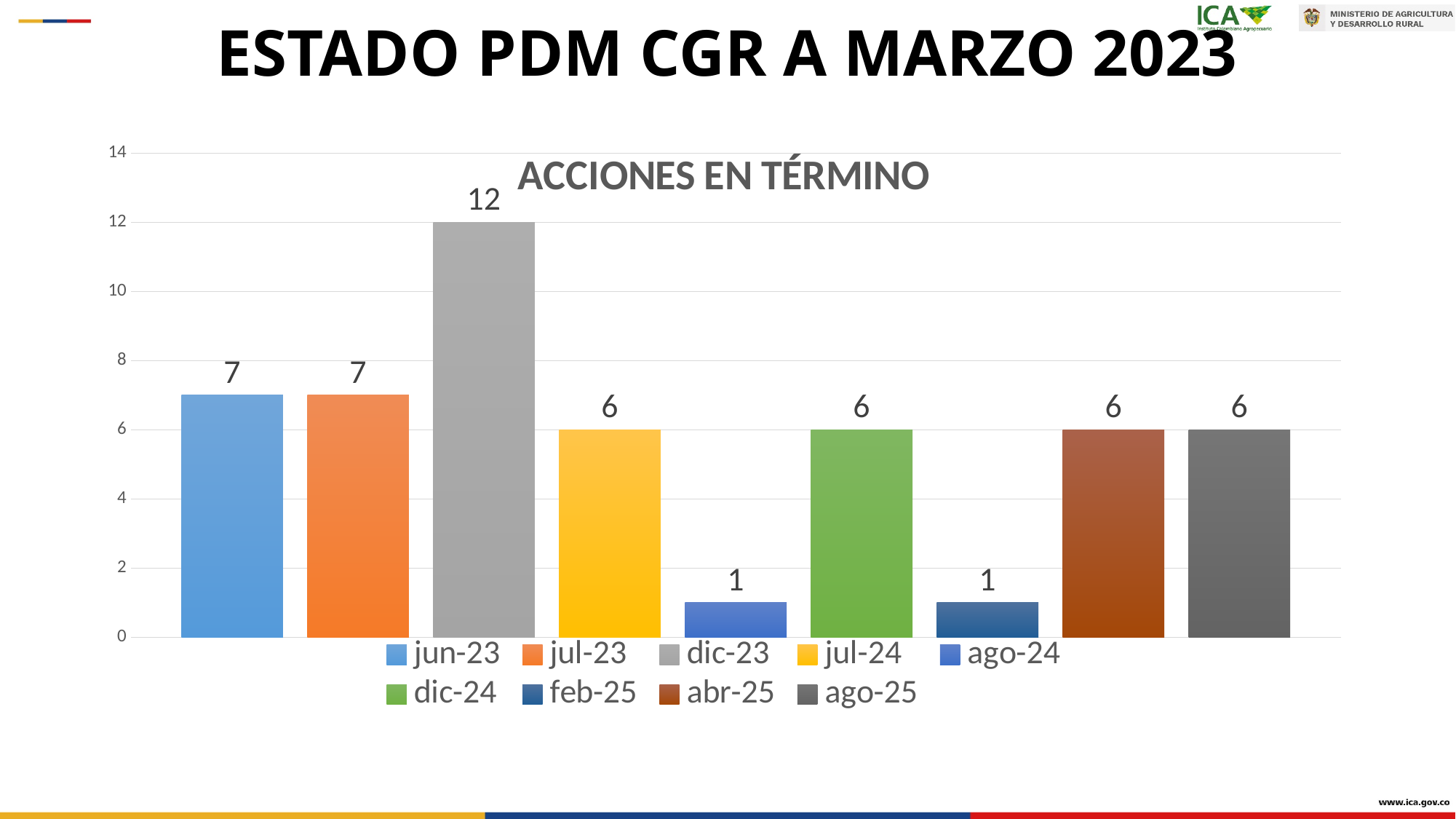
What is the value for abr-25 in the ACCIONES EN TÉRMINO chart? 6 Is the value for dic-23 in the ACCIONES EN TÉRMINO chart greater or less than 10? greater How many entries does the legend of the ACCIONES EN TÉRMINO chart list? 9 What is the difference between the values for jul-23 and feb-25 in the ACCIONES EN TÉRMINO chart? 6 How many bars are plotted in the ACCIONES EN TÉRMINO chart? 9 Which is larger in the ACCIONES EN TÉRMINO chart, the value for dic-24 or the value for ago-24? dic-24 What is the value for jun-23 in the ACCIONES EN TÉRMINO chart? 7 What is the value for dic-23 in the ACCIONES EN TÉRMINO chart? 12 What is the value for ago-24 in the ACCIONES EN TÉRMINO chart? 1 What type of chart is the ACCIONES EN TÉRMINO chart? Bar chart What is the difference between the values for dic-23 and jul-24 in the ACCIONES EN TÉRMINO chart? 6 Which category has the highest value in the ACCIONES EN TÉRMINO chart? dic-23